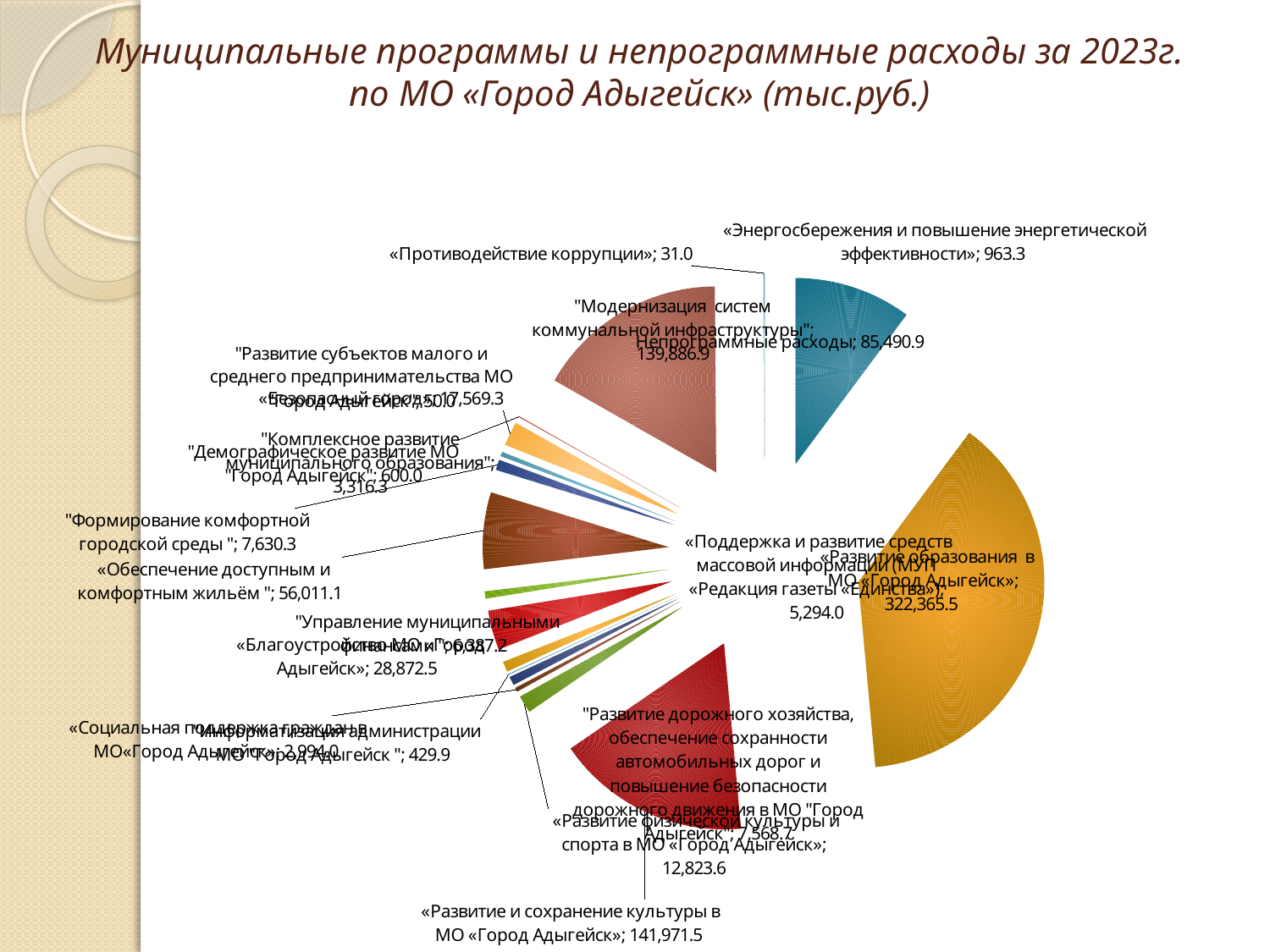
What is the difference between «Развитие и сохранение культуры в МО «Город Адыгейск» and Непрограммные расходы? 56,480.6 What is the title of the slide? Муниципальные программы и непрограммные расходы за 2023г. по МО «Город Адыгейск» (тыс.руб.) What value is shown for Непрограммные расходы? 85,490.9 What value is shown for «Развитие и сохранение культуры в МО «Город Адыгейск»? 141,971.5 What value is shown for «Противодействие коррупции»? 31.0 Which category has the largest slice of the pie? «Развитие образования в МО «Город Адыгейск» What kind of chart is shown on the slide? Pie chart Which is larger: Непрограммные расходы or «Развитие и сохранение культуры в МО «Город Адыгейск»? «Развитие и сохранение культуры в МО «Город Адыгейск» What value is shown for «Развитие образования в МО «Город Адыгейск»? 322,365.5 What value is shown for «Энергосбережения и повышение энергетической эффективности»? 963.3 What value is shown for «Формирование комфортной городской среды»? 7,630.3 What value is shown for «Обеспечение доступным и комфортным жильём»? 56,011.1